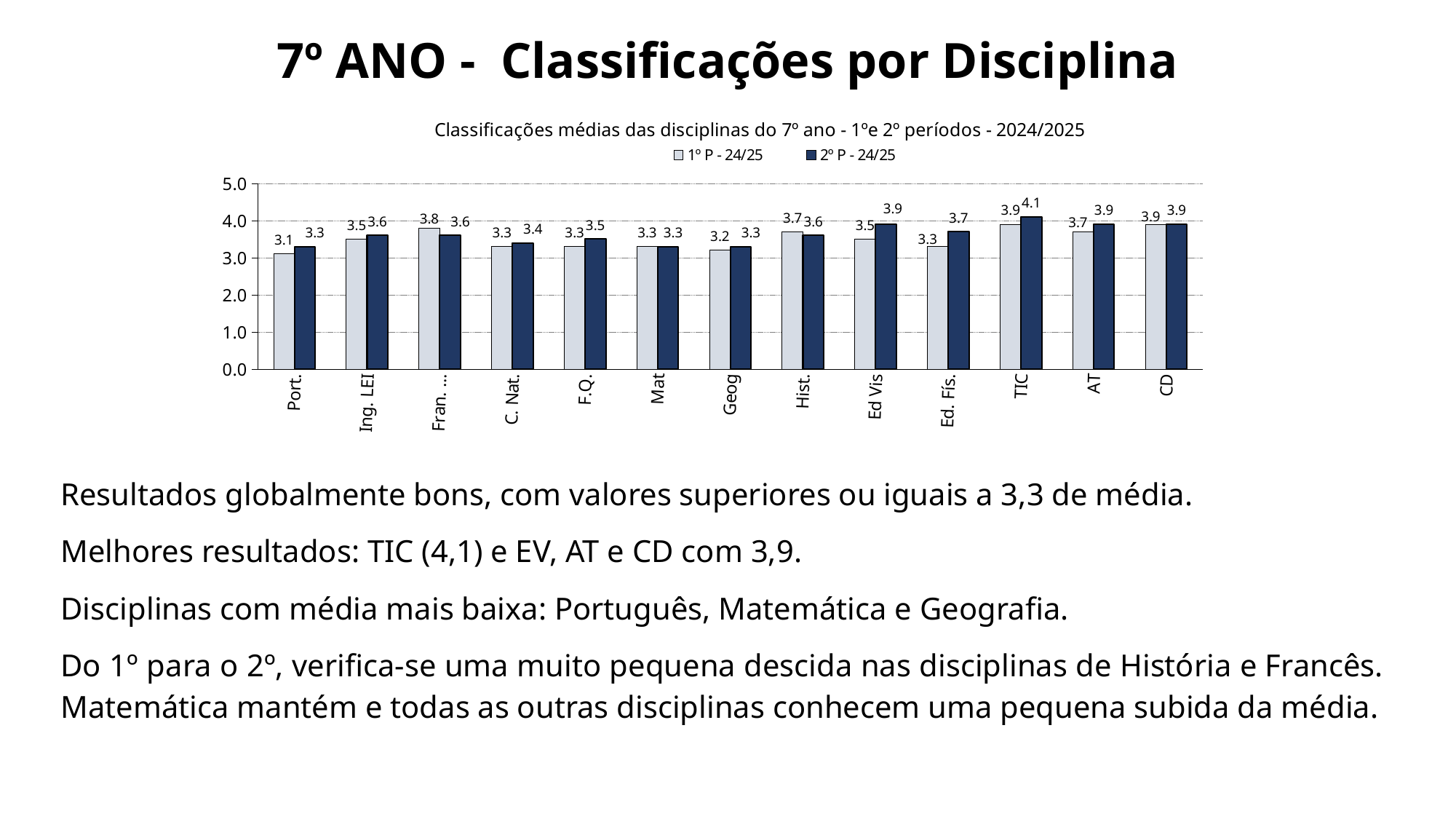
For Fran., which series has the larger value, 1º P - 24/25 or 2º P - 24/25? 1º P - 24/25 How many disciplines are shown on the x axis of the chart? 13 What is the difference between the 2º P - 24/25 and 1º P - 24/25 values for Ed. Fís.? 0.4 How many series does the chart legend list? 2 Is the 2º P - 24/25 value for TIC greater or less than 4.0? greater What is the value for Ed Vis in the 2º P - 24/25 series? 3.9 What is the title of the chart? Classificações médias das disciplinas do 7º ano - 1ºe 2º períodos - 2024/2025 Which discipline has the lowest value in the 1º P - 24/25 series? Port. What kind of chart is shown on the slide? bar chart What is the difference between the 2º P - 24/25 value for TIC and the 1º P - 24/25 value for Port.? 1.0 What is the value for Port. in the 1º P - 24/25 series? 3.1 Which discipline has the highest value in the 2º P - 24/25 series? TIC